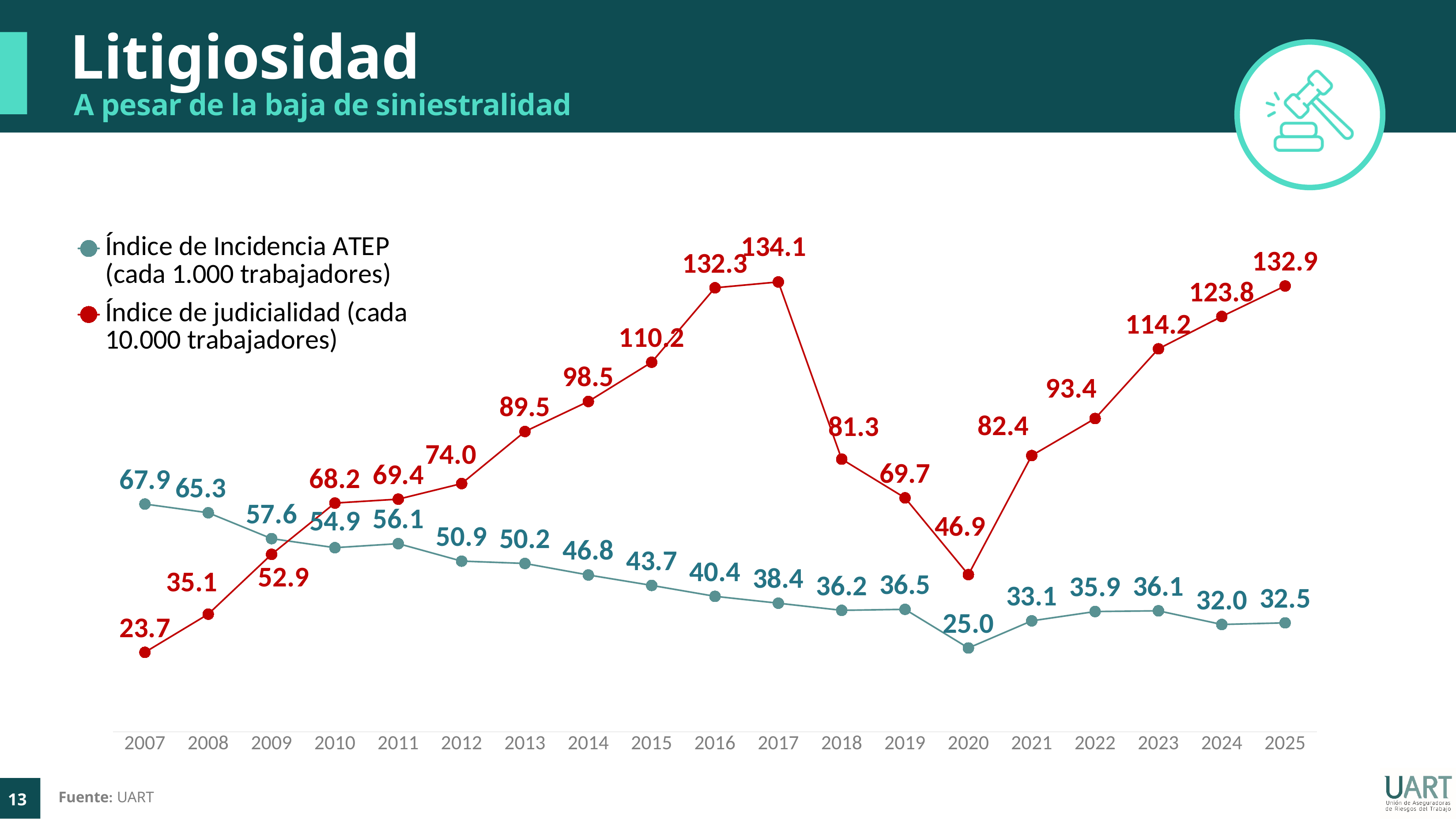
What kind of chart is shown on the slide? Line chart How many years are shown on the x axis? 19 In which year does the Índice de judicialidad reach its highest value? 2017 What is the Índice de Incidencia ATEP value for 2020? 25.0 What is the Índice de Incidencia ATEP value for 2025? 32.5 In which year is the Índice de Incidencia ATEP at its lowest? 2020 What is the Índice de judicialidad value for 2007? 23.7 What is the difference between the Índice de judicialidad and the Índice de Incidencia ATEP in 2025? 100.4 How many series does the legend list? 2 What is the Índice de judicialidad value for 2017? 134.1 In which year is the Índice de judicialidad at its lowest? 2007 Which is larger in 2008: the Índice de Incidencia ATEP or the Índice de judicialidad? Índice de Incidencia ATEP